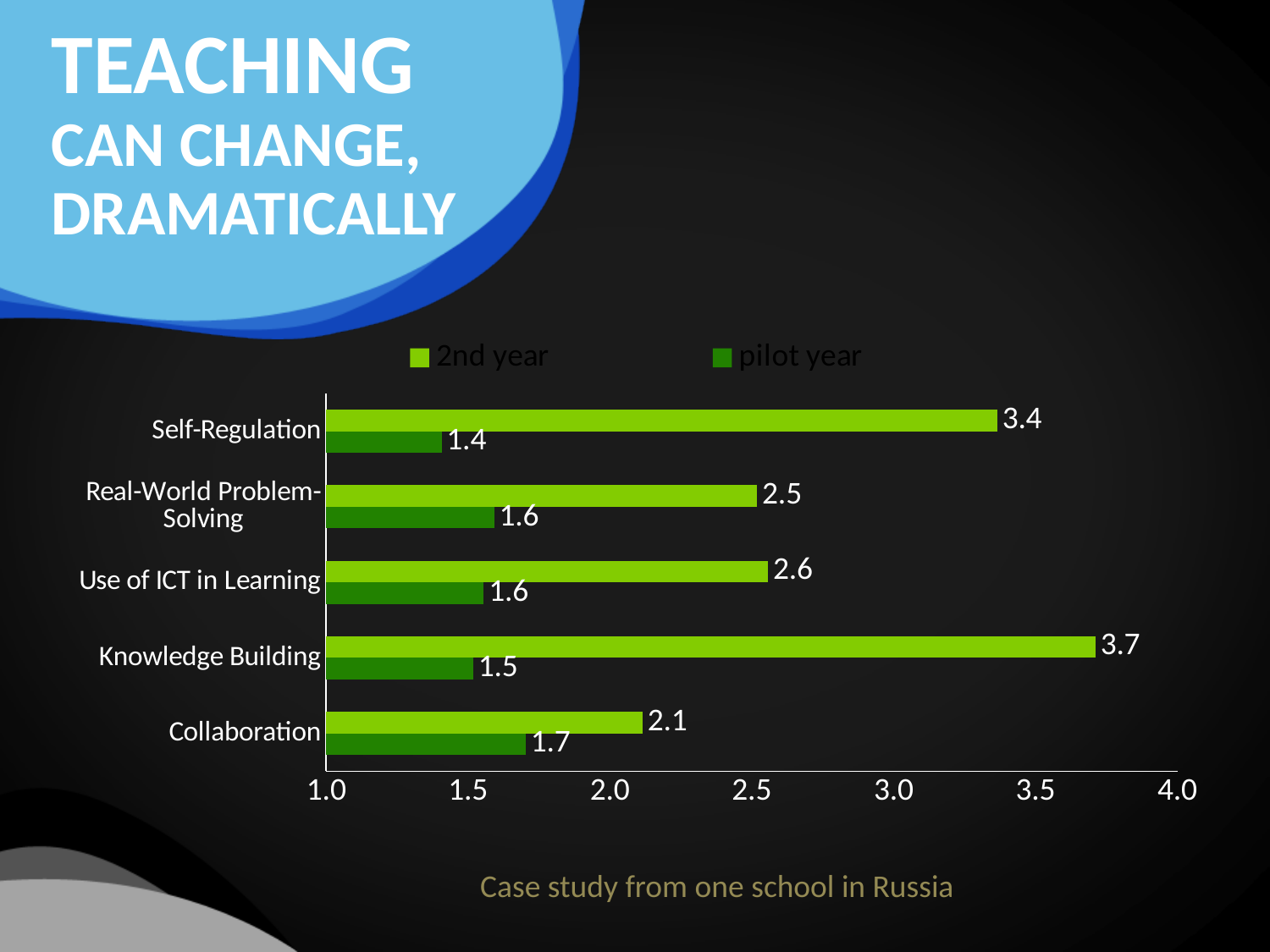
What are the two series named in the legend? 2nd year and pilot year Which category has the lowest pilot year value? Self-Regulation How many series does the legend list? 2 What is the 2nd year value for Use of ICT in Learning? 2.6 Which is larger, the 2nd year value for Real-World Problem-Solving or the 2nd year value for Collaboration? Real-World Problem-Solving What is the difference between the 2nd year and pilot year values for Self-Regulation? 2.0 What is the pilot year value for Collaboration? 1.7 What kind of chart is shown on the slide? bar chart Which category has the highest 2nd year value? Knowledge Building Is the 2nd year value for Self-Regulation greater or less than 3.0? greater What is the 2nd year value for Knowledge Building? 3.7 How many categories are plotted on the chart? 5